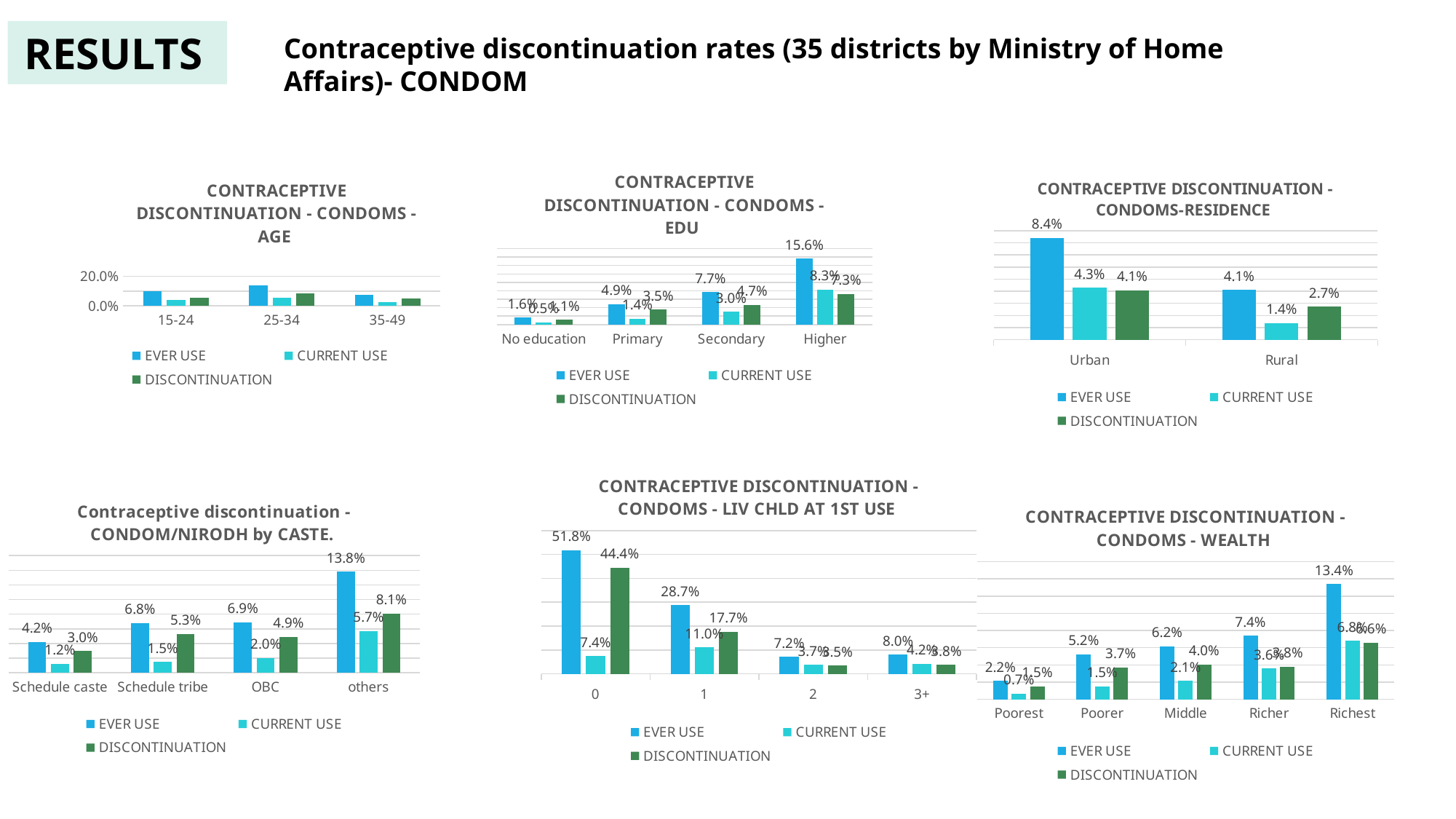
In the CONTRACEPTIVE DISCONTINUATION - CONDOMS-RESIDENCE chart, what is the EVER USE value for Urban? 8.4% In the CONTRACEPTIVE DISCONTINUATION - CONDOMS - LIV CHLD AT 1ST USE chart, which category has the highest EVER USE value? 0 What kind of chart is the CONTRACEPTIVE DISCONTINUATION - CONDOMS - LIV CHLD AT 1ST USE chart? Bar chart In the Contraceptive discontinuation - CONDOM/NIRODH by CASTE chart, which is larger: the DISCONTINUATION value for Schedule tribe or for OBC? Schedule tribe How many series does the legend of the CONTRACEPTIVE DISCONTINUATION - CONDOMS - EDU chart list? 3 In the CONTRACEPTIVE DISCONTINUATION - CONDOMS - AGE chart, is the EVER USE value for 25-34 greater or less than 20.0%? less In the CONTRACEPTIVE DISCONTINUATION - CONDOMS - EDU chart, do the EVER USE values rise or fall from No education to Higher? Rise In the Contraceptive discontinuation - CONDOM/NIRODH by CASTE chart, what is the CURRENT USE value for others? 5.7% In the CONTRACEPTIVE DISCONTINUATION - CONDOMS - EDU chart, what is the DISCONTINUATION value for Higher? 7.3% How many categories are shown on the x axis of the CONTRACEPTIVE DISCONTINUATION - CONDOMS - WEALTH chart? 5 In the CONTRACEPTIVE DISCONTINUATION - CONDOMS - WEALTH chart, which category has the lowest CURRENT USE value? Poorest In the CONTRACEPTIVE DISCONTINUATION - CONDOMS-RESIDENCE chart, what is the difference between the EVER USE values for Urban and Rural? 4.3%